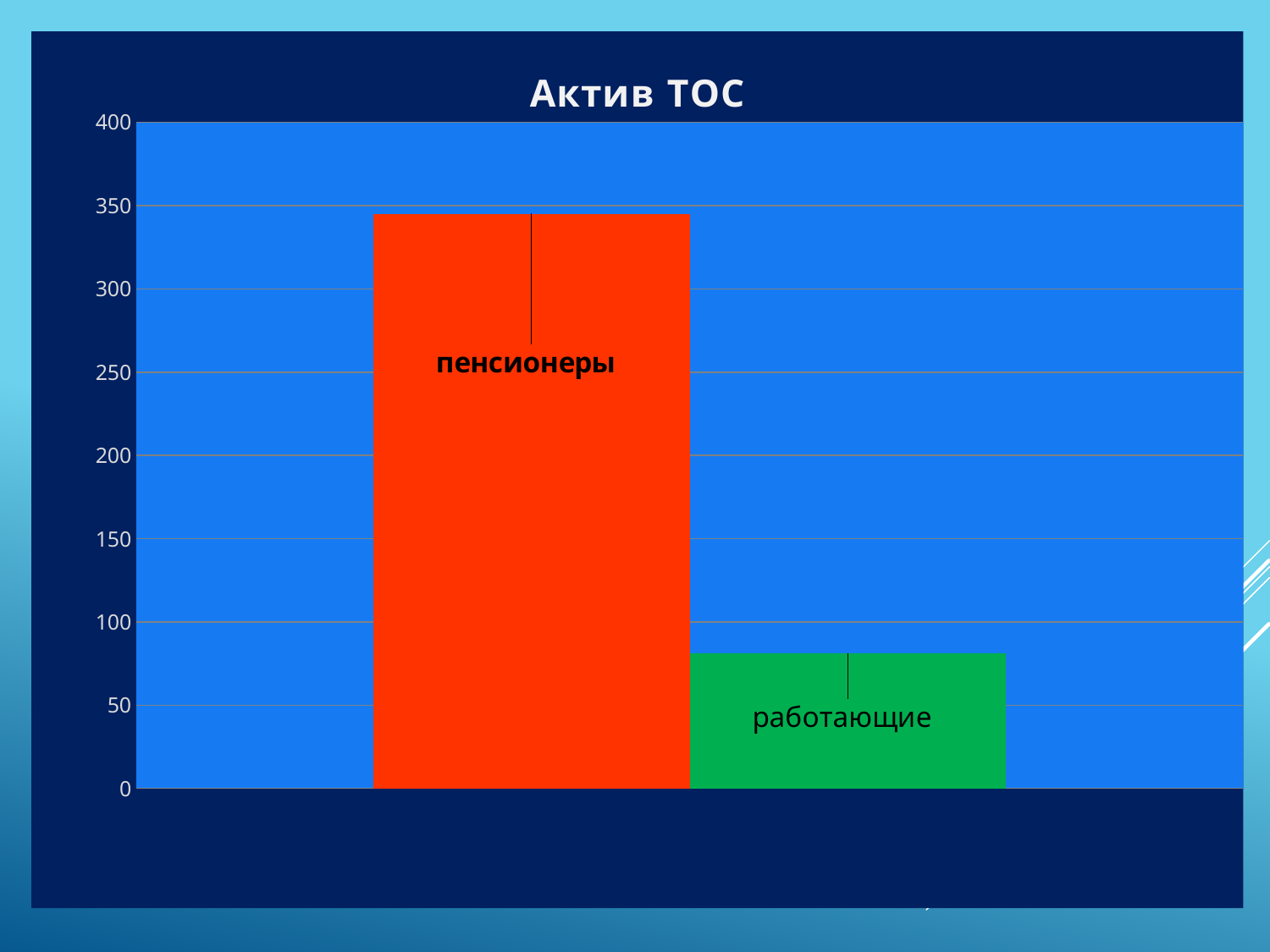
Which is larger, the value for пенсионеры or the value for работающие? пенсионеры Is the value for пенсионеры greater or less than 300? greater How many bars are plotted in the chart? 2 Which category has the highest value? пенсионеры What colour is the bar for пенсионеры? red What kind of chart is shown on the slide? bar chart What is the highest value shown on the vertical axis? 400 Which category has the lowest value? работающие What is the title of the chart? Актив ТОС Is the value for пенсионеры greater or less than 350? less Is the value for работающие greater or less than 50? greater